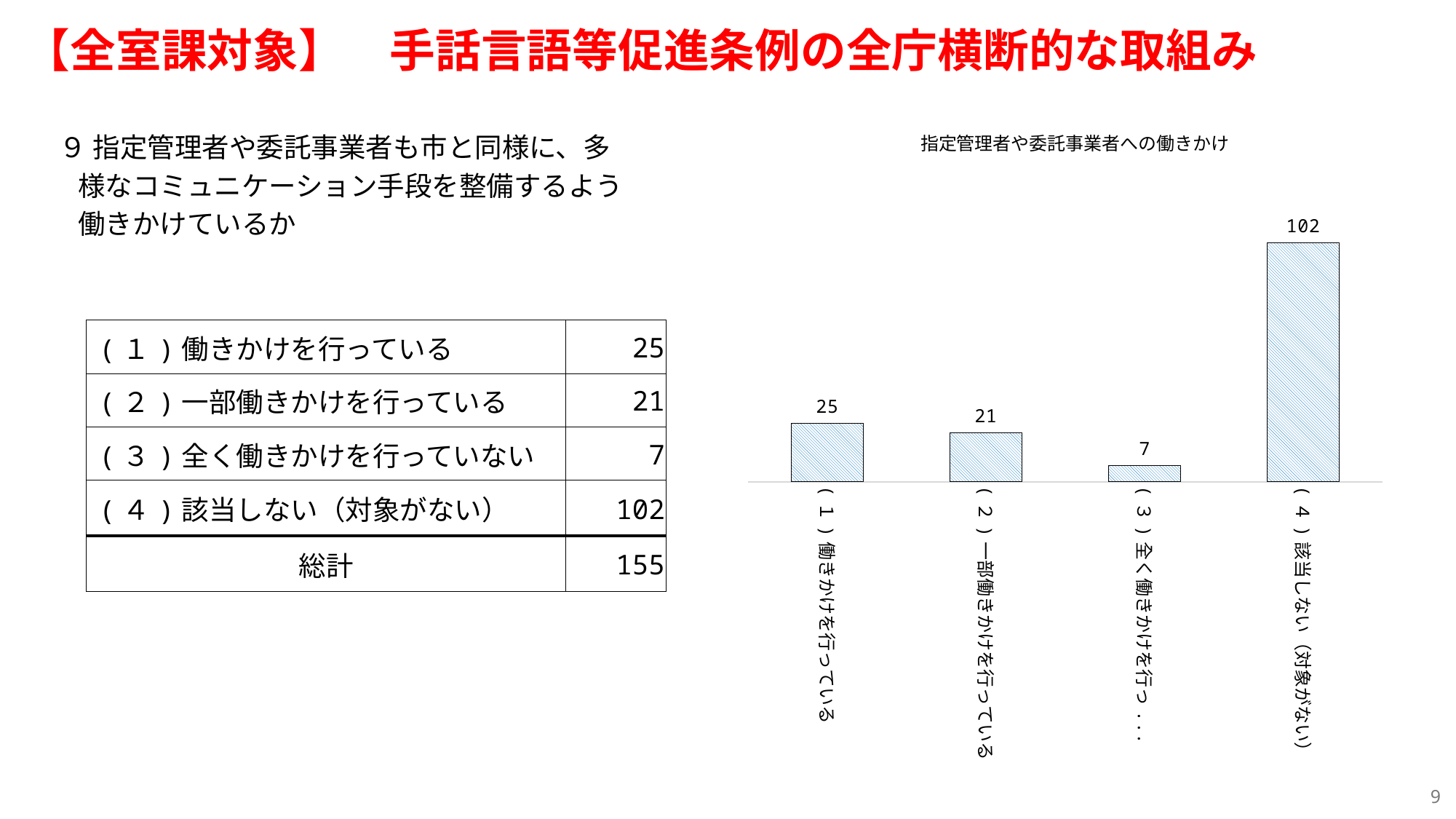
Which is larger, the value for （１）働きかけを行っている or （３）全く働きかけを行っていない? （１）働きかけを行っている What is the difference between the values for （１）働きかけを行っている and （２）一部働きかけを行っている? 4 What is the value for （２）一部働きかけを行っている in the chart? 21 How many categories are shown in the chart? 4 What is the difference between the values for （４）該当しない（対象がない） and （１）働きかけを行っている? 77 Which category has the highest value in the chart? （４）該当しない（対象がない） Which category has the lowest value in the chart? （３）全く働きかけを行っていない What kind of chart is shown on the slide? bar chart What is the value for （１）働きかけを行っている in the chart? 25 What is the title of the chart? 指定管理者や委託事業者への働きかけ What is the value for （４）該当しない（対象がない） in the chart? 102 What is the value for （３）全く働きかけを行っていない in the chart? 7